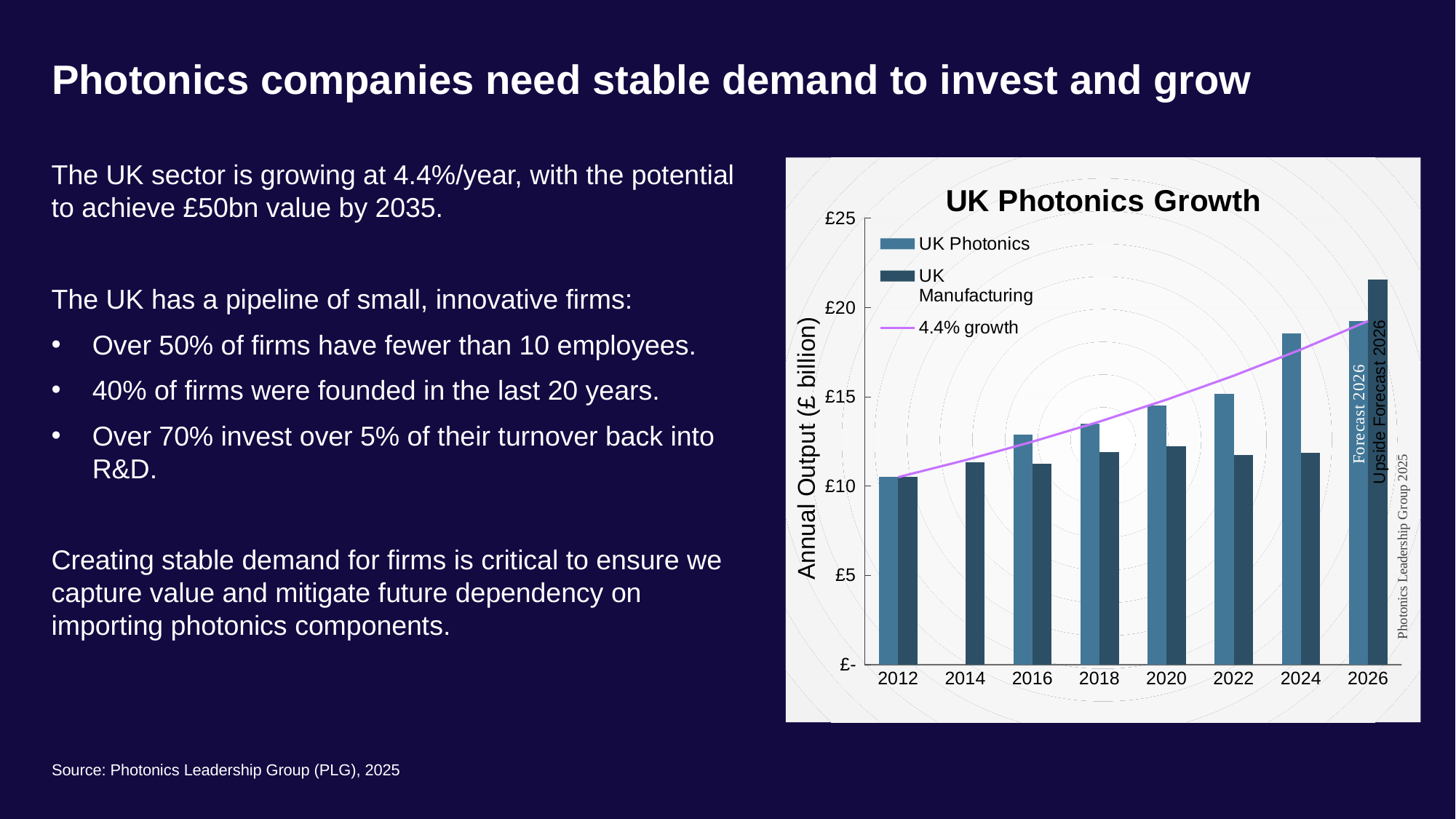
Is the UK Manufacturing value for 2022 greater or less than £15? less Do the UK Photonics values rise or fall from 2012 to 2026? rise How many entries does the legend of the UK Photonics Growth chart list? 3 Is the UK Photonics value for 2024 greater or less than £15? greater Is the UK Photonics value for 2012 greater or less than £15? less What is the y-axis title of the UK Photonics Growth chart? Annual Output (£ billion) How many years are shown on the x axis of the UK Photonics Growth chart? 8 In 2026, which is larger: UK Photonics or UK Manufacturing? UK Manufacturing What kind of chart is the UK Photonics Growth chart? combination bar and line chart Which year has the highest UK Photonics bar? 2026 In 2024, which is larger: UK Photonics or UK Manufacturing? UK Photonics